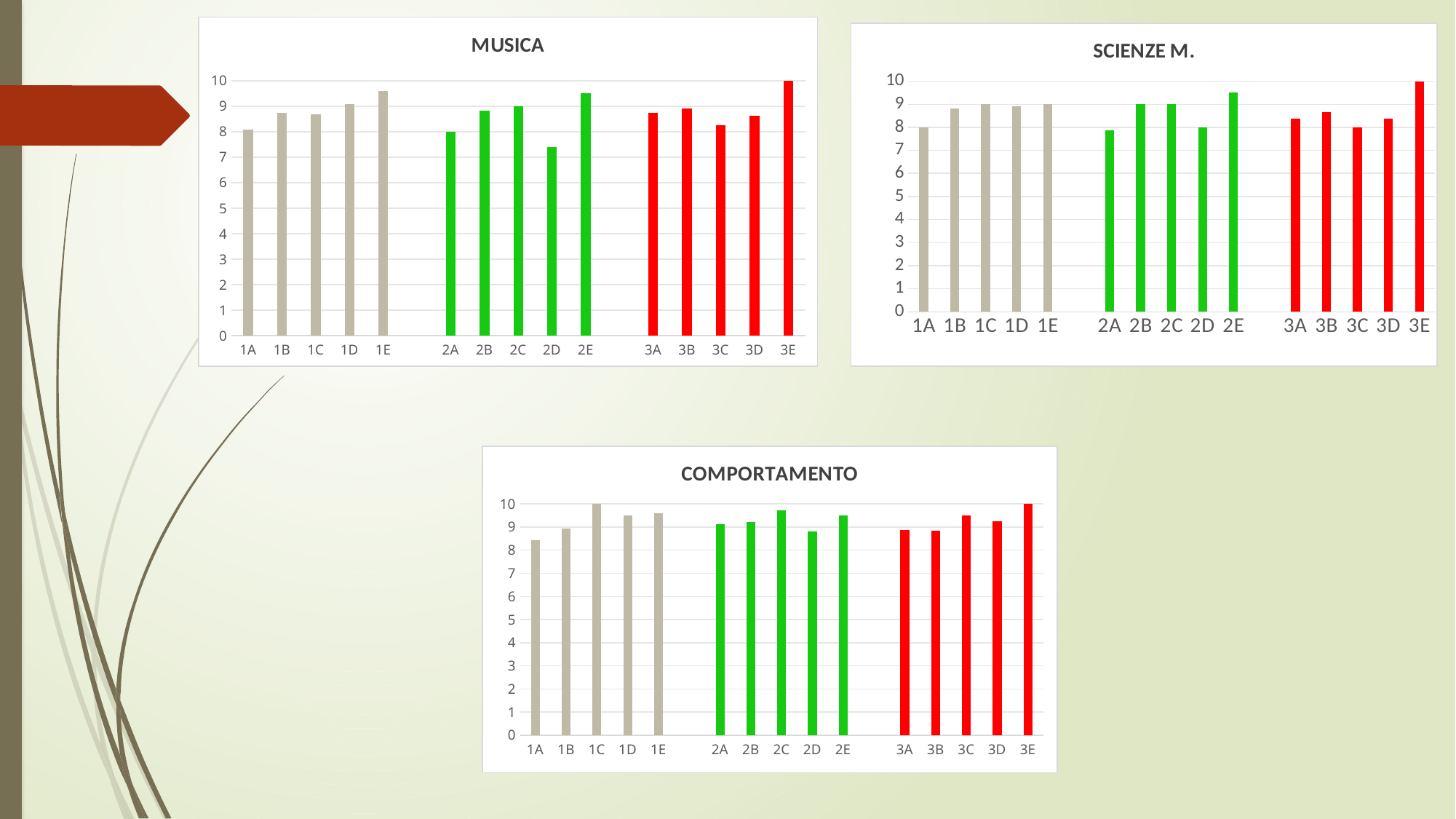
In the MUSICA chart, which class has the lowest value? 2D In the SCIENZE M. chart, which class has the highest value? 3E In the MUSICA chart, is the value for 2D greater or less than 8? less In the SCIENZE M. chart, is the value for 2E greater or less than 9? greater In the MUSICA chart, which is larger, the value for 1A or the value for 1E? 1E What type of chart is the MUSICA chart? bar chart In the MUSICA chart, which class has the highest value? 3E In the COMPORTAMENTO chart, which is larger, the value for 2C or the value for 2D? 2C How many classes are shown on the x axis of the MUSICA chart? 15 In the COMPORTAMENTO chart, what is the value for 1C? 10 In the MUSICA chart, what is the value for 3E? 10 In the COMPORTAMENTO chart, which class has the lowest value? 1A